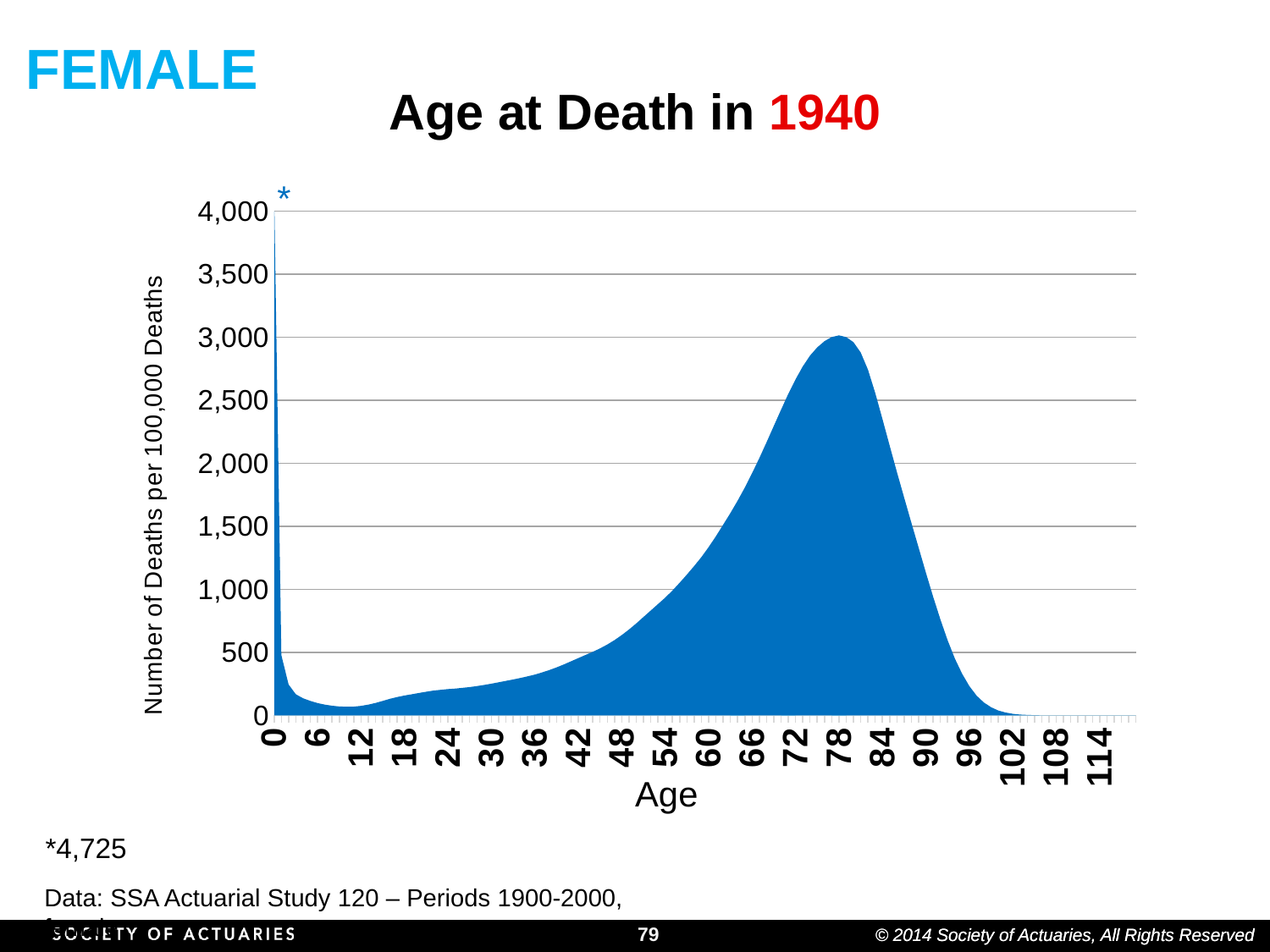
Between age 12 and age 78, do the values rise or fall? rise Which has a larger number of deaths per 100,000 deaths: age 78 or age 6? age 78 Is the value at age 78 greater or less than 2,500? greater Is the value at age 102 greater or less than 500? less What kind of chart is shown on the slide? area chart At which age is the number of deaths per 100,000 deaths highest? 0 Is the value at age 24 greater or less than 500? less What is the label of the vertical axis? Number of Deaths per 100,000 Deaths Between age 78 and age 102, do the values rise or fall? fall What is the number of deaths per 100,000 deaths at age 0, as given by the asterisk footnote? 4,725 Which has a larger number of deaths per 100,000 deaths: age 0 or age 78? age 0